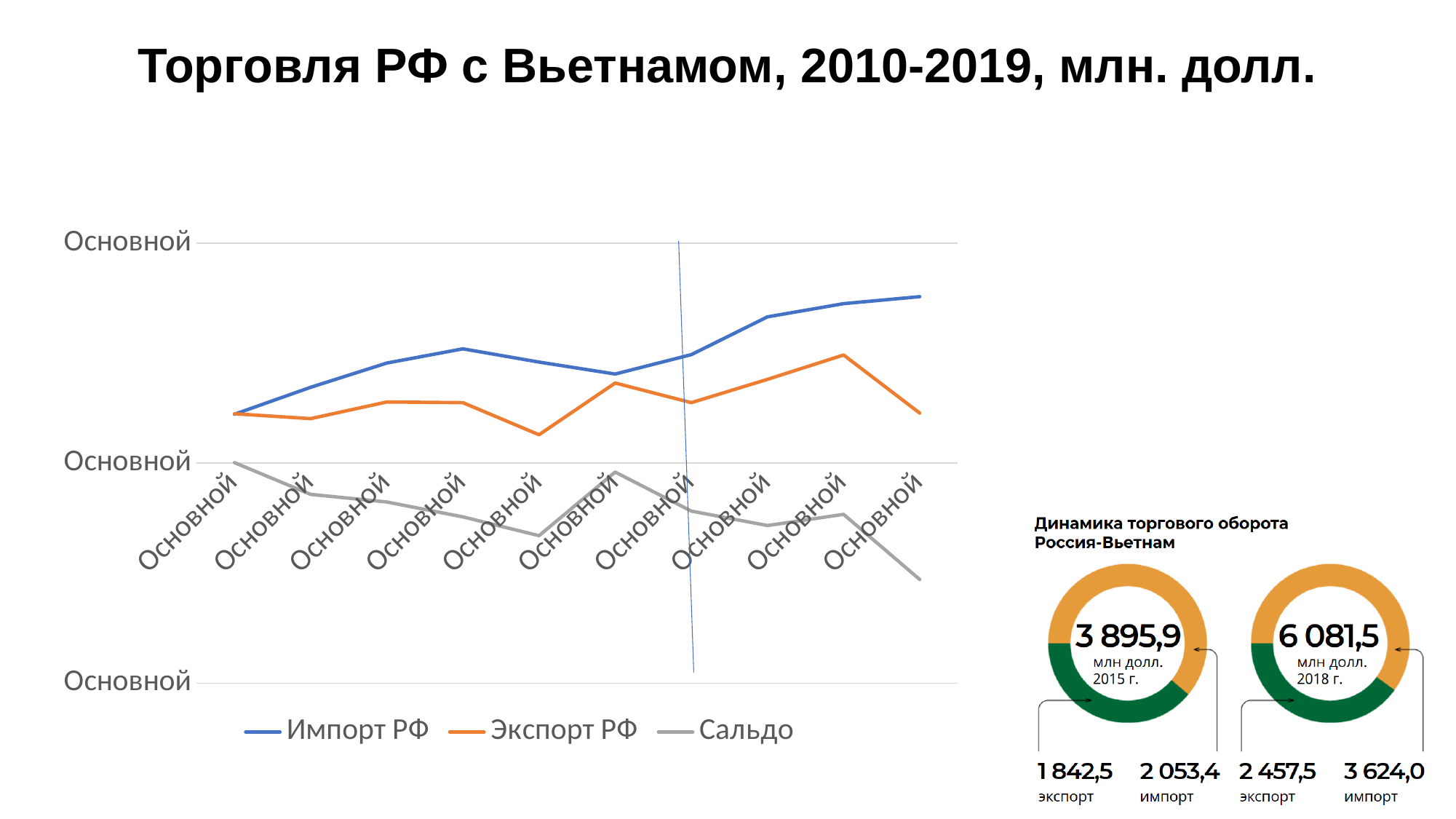
In the donut chart for 2018 г. (Динамика торгового оборота Россия-Вьетнам), what is the difference between импорт and экспорт? 1 166,5 In the line chart on the left, which series has the lowest values across the chart? Сальдо In the line chart on the left, which series has the highest values at the right end of the chart? Импорт РФ In the line chart on the left, does the Сальдо line generally rise or fall from left to right? fall In the donut chart for 2015 г. (Динамика торгового оборота Россия-Вьетнам), what is the value for импорт? 2 053,4 In the donut chart for 2018 г. (Динамика торгового оборота Россия-Вьетнам), what is the total trade turnover shown in the centre? 6 081,5 What kind of chart is the large chart on the left of the slide? line chart In the donut chart for 2015 г. (Динамика торгового оборота Россия-Вьетнам), what is the value for экспорт? 1 842,5 What are the three series named in the legend of the line chart on the left? Импорт РФ, Экспорт РФ, Сальдо In the donut chart for 2018 г. (Динамика торгового оборота Россия-Вьетнам), which is larger, экспорт or импорт? импорт How many data points does each line in the line chart on the left have? 10 How many series does the legend of the line chart on the left list? 3